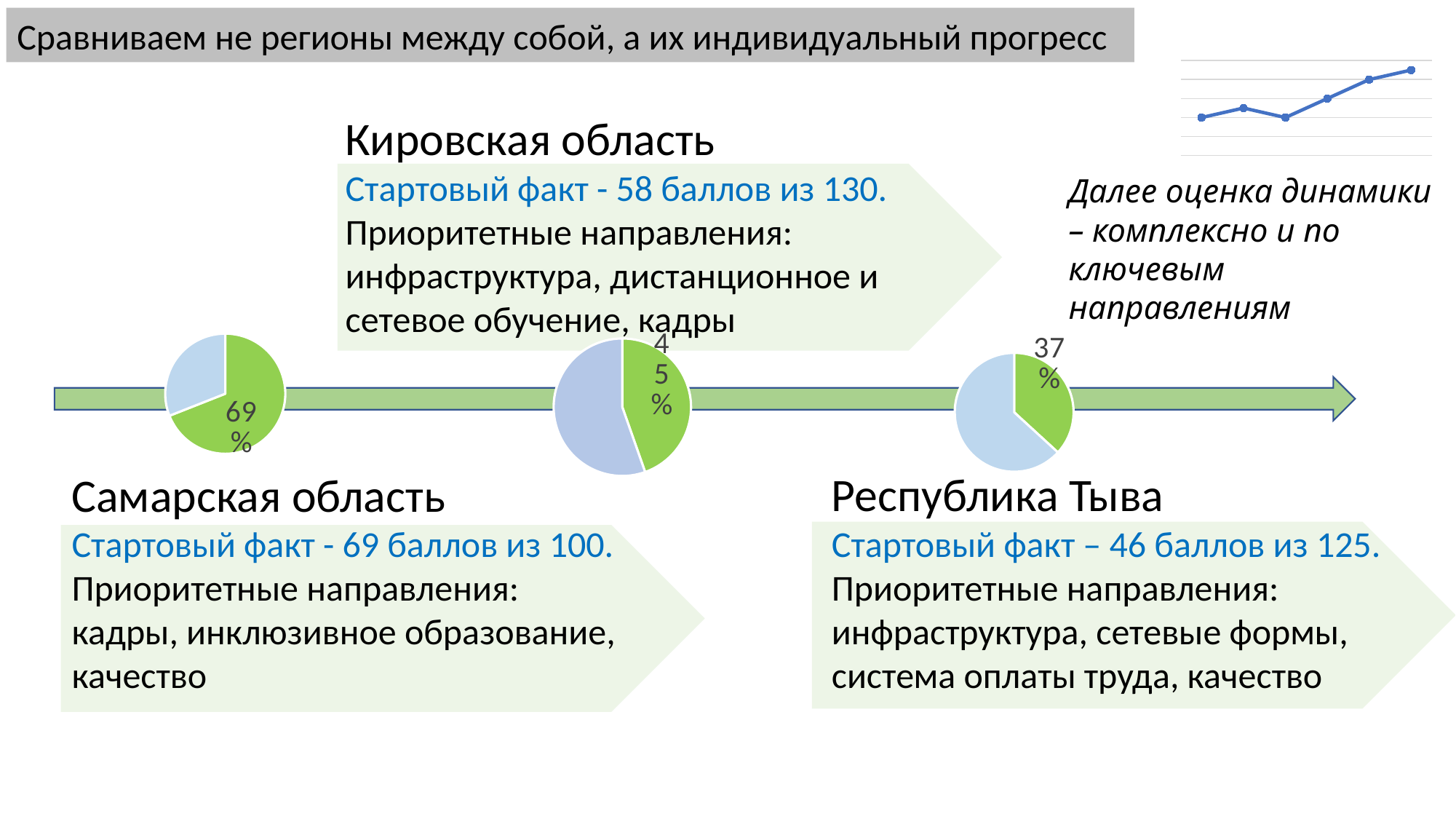
Which of the three pie charts on the arrow has the largest green share? the leftmost (Самарская область), 69% What kind of chart is the leftmost chart on the green arrow (next to Самарская область)? pie chart In the leftmost pie chart (Самарская область), what percentage is printed on the green slice? 69% What kind of chart is the small chart in the top-right corner of the slide? line chart Which green share is larger: the middle pie chart (Кировская область) or the rightmost pie chart (Республика Тыва)? the middle pie chart (45%) In the middle pie chart (Кировская область), what percentage is printed on the green slice? 45% What is the difference between the green share in the leftmost pie chart (69%) and the rightmost pie chart (37%)? 32% Which of the three pie charts on the arrow has the smallest green share? the rightmost (Республика Тыва), 37% In the rightmost pie chart (Республика Тыва), what percentage is printed on the green slice? 37% On the small line chart in the top-right corner, do the values overall rise or fall from left to right? rise How many data points are plotted on the small line chart in the top-right corner? 6 How many pie charts are placed along the green arrow on the slide? 3